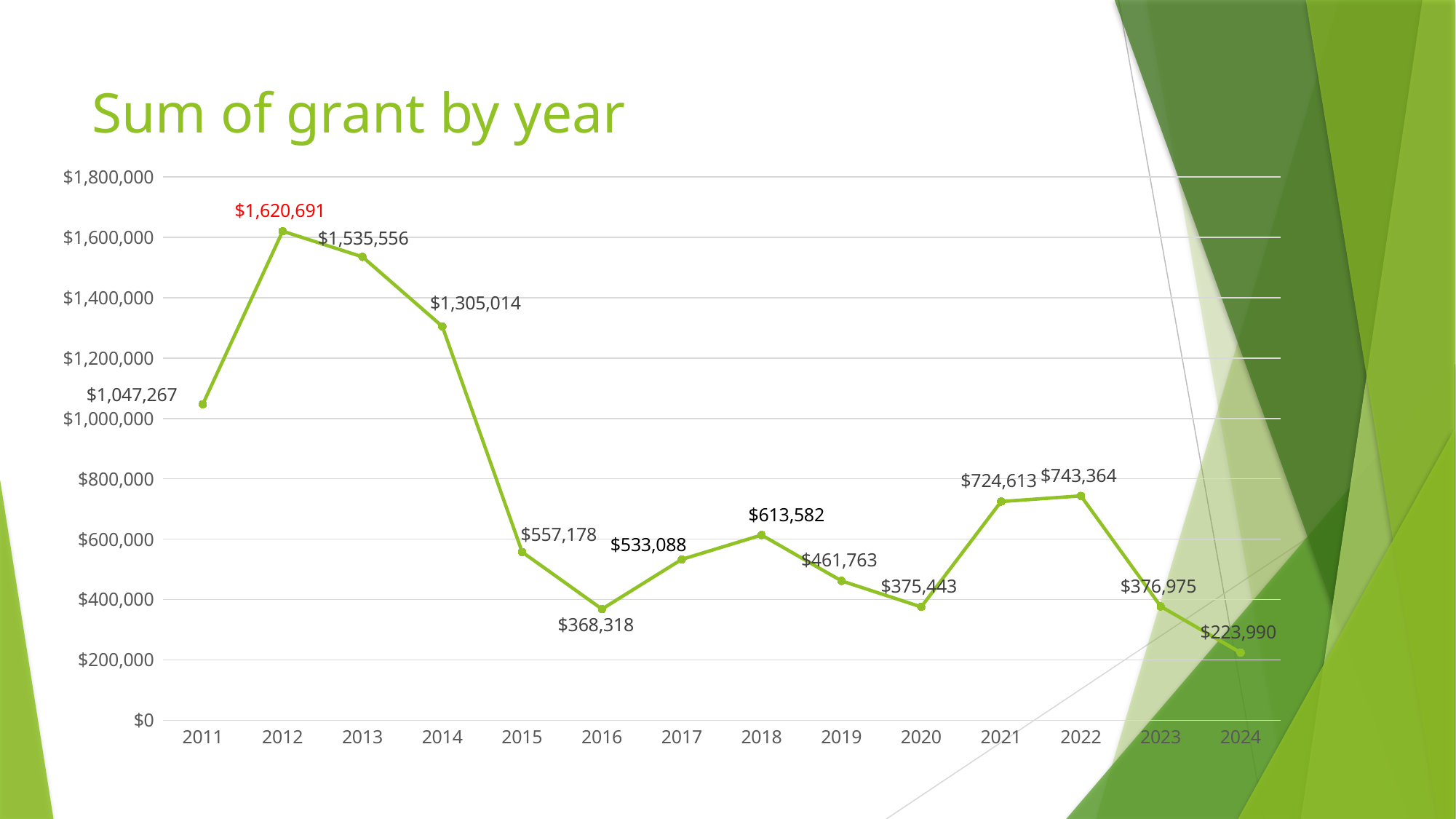
What kind of chart is shown on the slide? line chart Is the value for 2014 greater or less than $1,200,000? greater What is the sum of grant for 2012? $1,620,691 How many years are plotted on the chart? 14 What is the difference between the sum of grant in 2022 and in 2021? $18,751 What is the sum of grant for 2024? $223,990 What is the difference between the sum of grant in 2012 and in 2013? $85,135 Do the values rise or fall from 2014 to 2016? fall Which year has the highest sum of grant? 2012 What is the sum of grant for 2016? $368,318 Which year has a larger sum of grant, 2018 or 2019? 2018 Which year has the lowest sum of grant? 2024